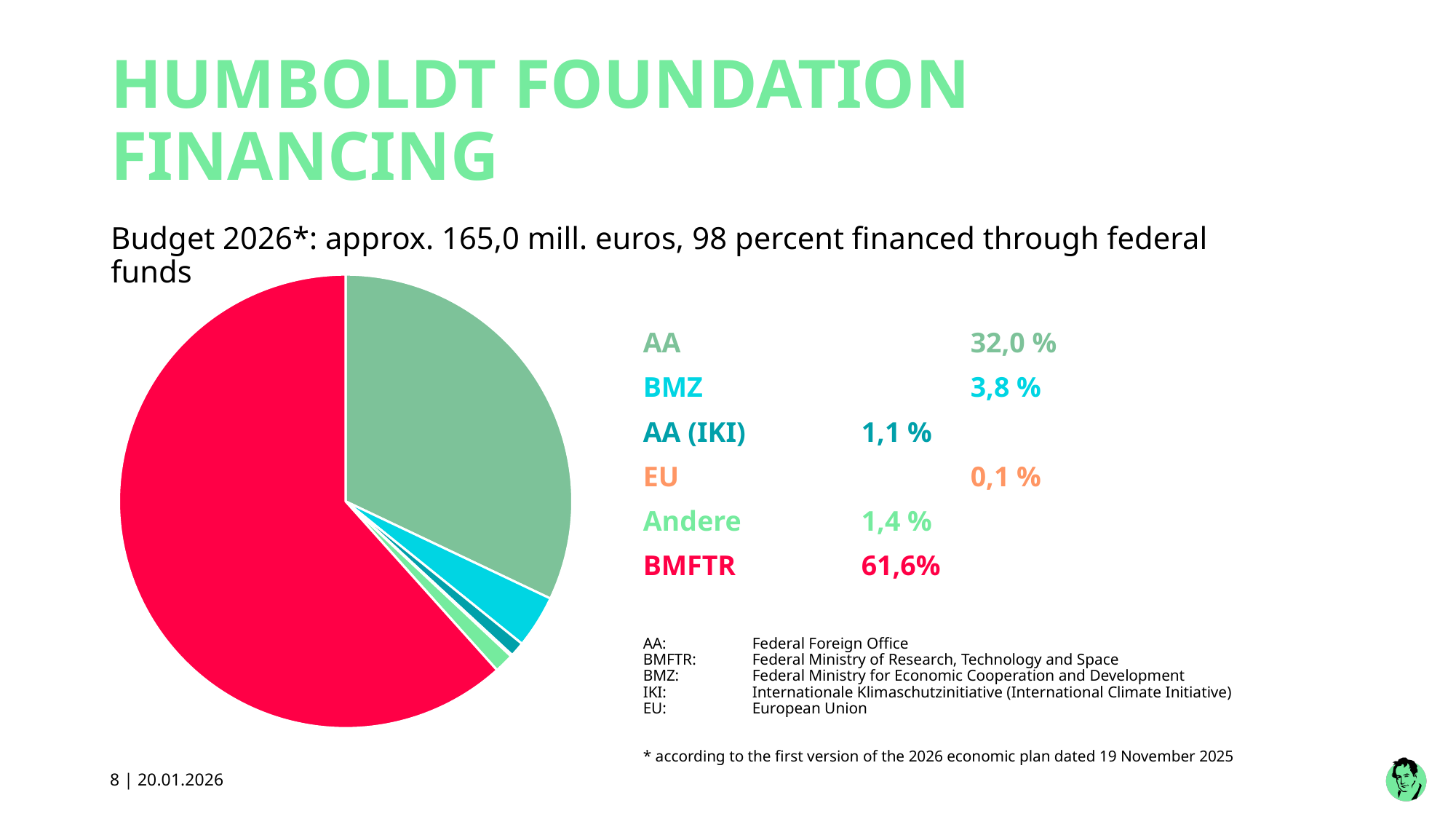
Which is larger, the share for BMZ or the share for AA (IKI)? BMZ What colour is the BMFTR slice of the pie chart? red Which funding source has the smallest share of the pie? EU What is the difference in percentage points between the BMFTR share and the AA share? 29,6 What share of the Humboldt Foundation financing comes from BMFTR? 61,6% What share of the financing comes from the EU? 0,1 % How many funding sources are listed for the pie chart? 6 What share of the financing comes from AA? 32,0 % What kind of chart is shown on the slide? pie chart What share of the financing is listed under Andere? 1,4 % Which funding source has the largest share of the pie? BMFTR What share of the financing comes from BMZ? 3,8 %